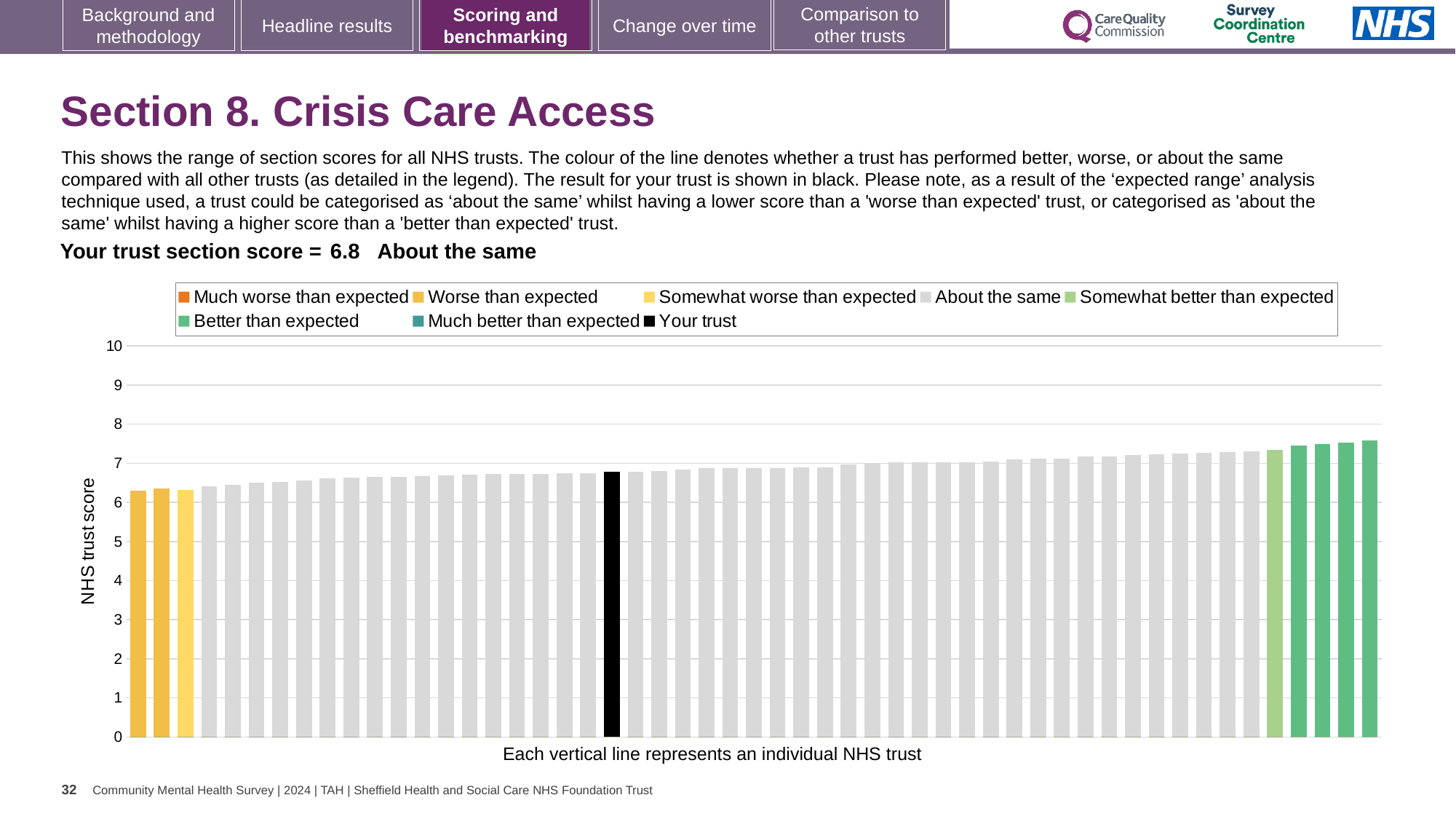
How many trusts are shown in the 'Worse than expected' colour? 2 How many trusts are shown in the 'Better than expected' colour? 4 What is the section score for your trust shown on the slide? 6.8 Is the value of the highest bar on the chart greater or less than 7? greater Is the value for your trust (the black bar) greater or less than 5? greater What is the label on the vertical axis of the chart? NHS trust score What kind of chart is used to show the NHS trust scores? bar chart Do the trust scores rise or fall from left to right along the x axis? rise How many entries does the chart legend list? 8 Is the value of the lowest bar on the chart greater or less than 7? less Which performance category is your trust placed in for Crisis Care Access? About the same How many trusts are shown in the 'Somewhat better than expected' colour? 1